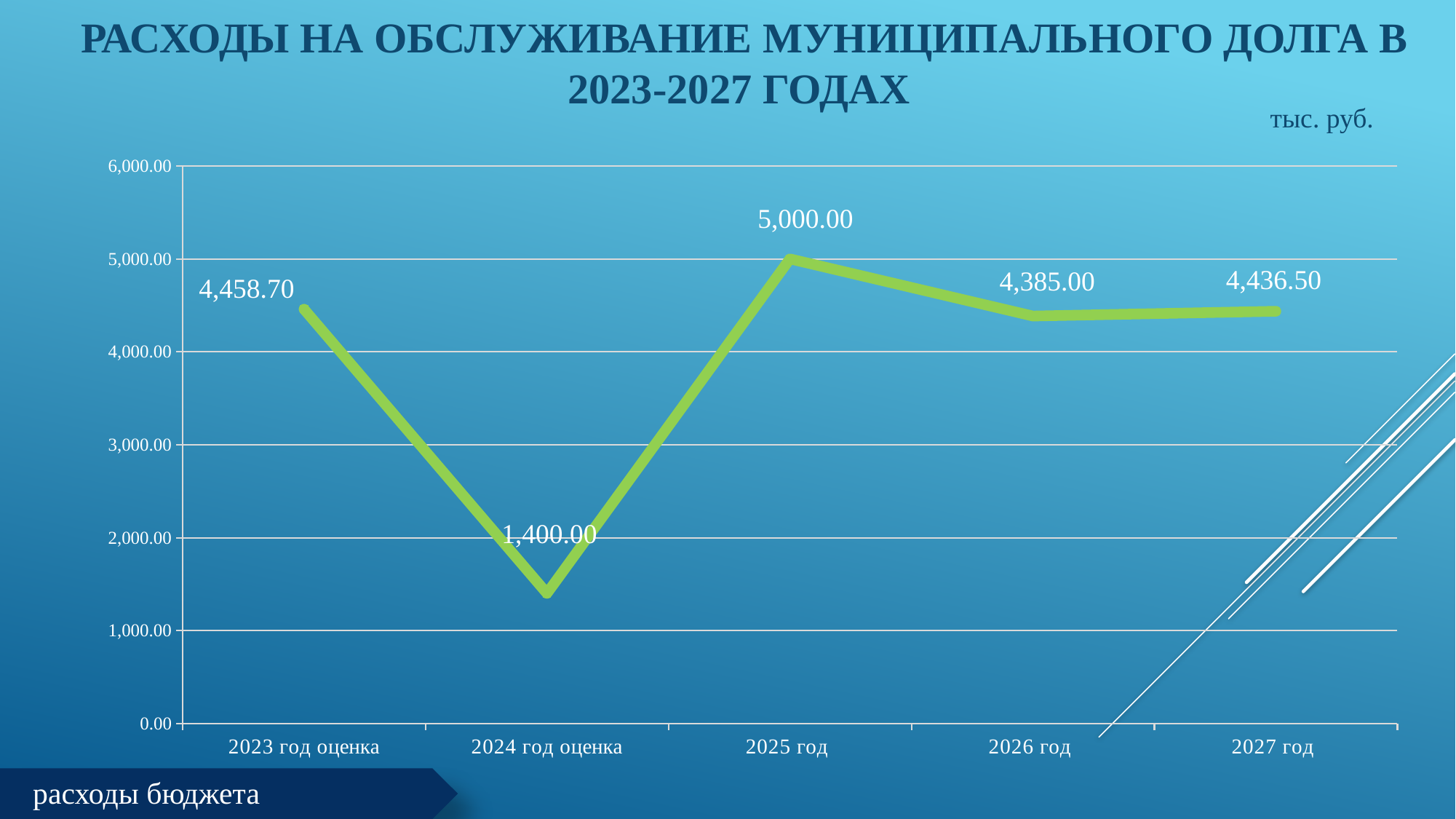
What is the value for 2024 год оценка? 1,400.00 What unit of measurement is indicated for the chart values? тыс. руб. What is the value for 2025 год? 5,000.00 Which year has the highest value? 2025 год What is the value for 2027 год? 4,436.50 How many data points are plotted on the chart? 5 What is the value for 2023 год оценка? 4,458.70 Which is larger, the value for 2023 год оценка or the value for 2026 год? 2023 год оценка What kind of chart is shown on the slide? line chart What is the difference between the values for 2027 год and 2026 год? 51.50 What is the difference between the values for 2025 год and 2024 год оценка? 3,600.00 Which year has the lowest value? 2024 год оценка